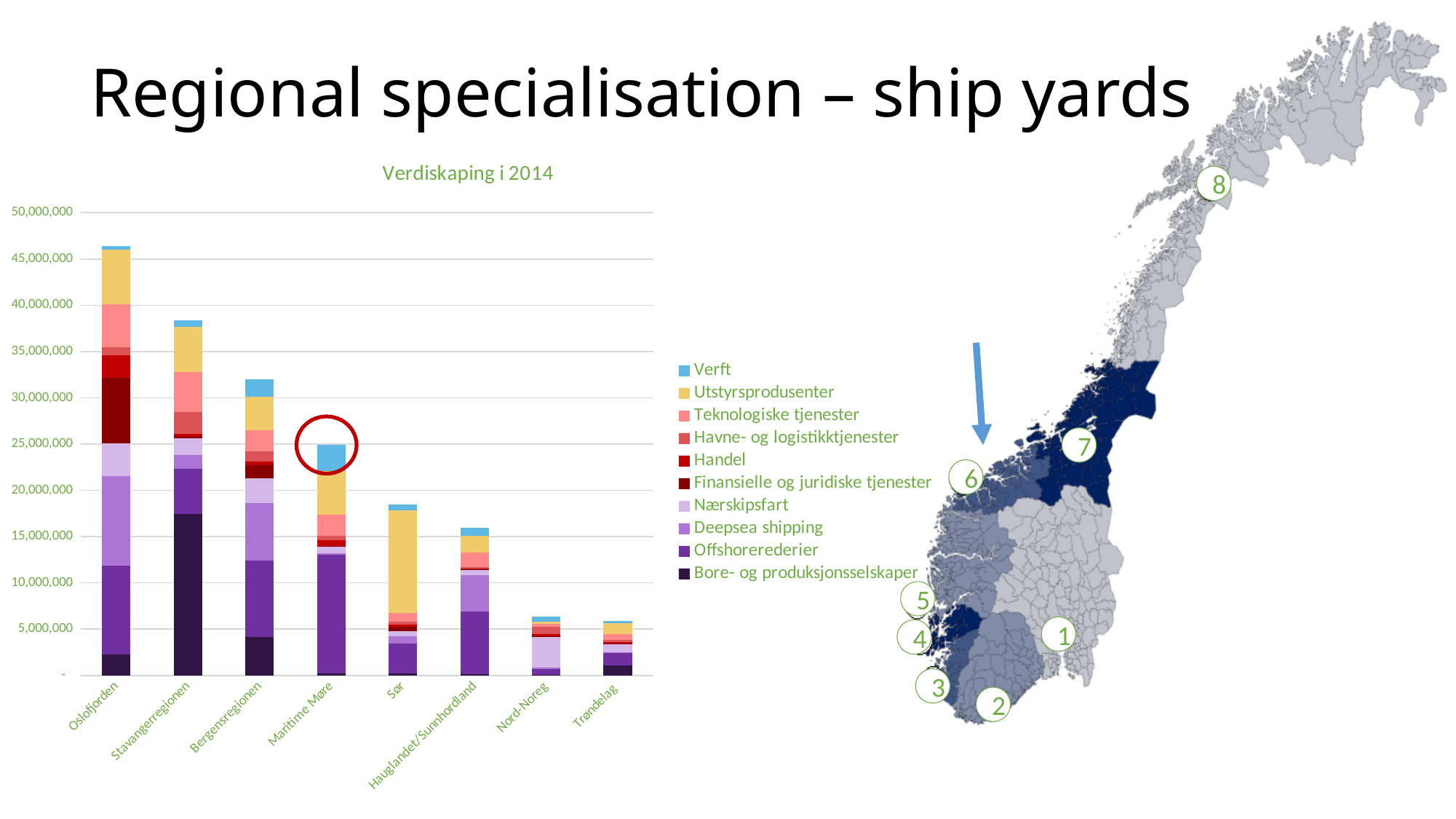
How many regions (categories) are shown on the x axis of the chart? 8 Is the total value for Oslofjorden greater or less than 45,000,000? greater Do the total bar heights generally rise or fall moving from left to right along the x axis? fall What is the title of the chart? Verdiskaping i 2014 Which region has the highest total bar in the chart? Oslofjorden Which has the larger total bar, Stavangerregionen or Bergensregionen? Stavangerregionen Is the total value for Bergensregionen greater or less than 30,000,000? greater Which region's bar is highlighted with a red circle on the chart? Maritime Møre Is the total value for Sør greater or less than 20,000,000? less How many series does the chart's legend list? 10 What kind of chart is shown on the slide? Stacked bar chart